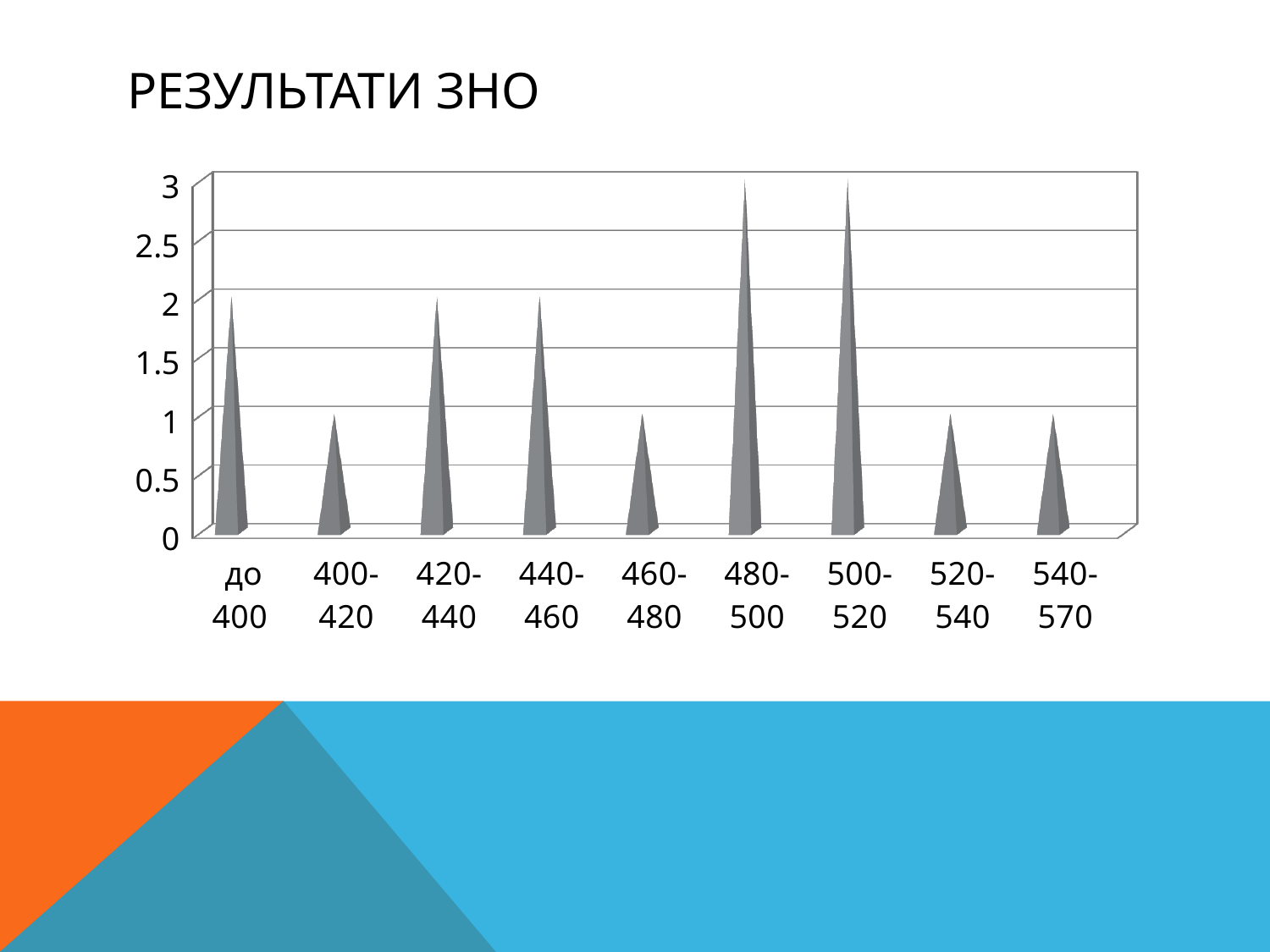
Which is larger, the value for до 400 or the value for 400-420? до 400 What is the value for the category до 400? 2 Is the value for 500-520 greater or less than 2.5? greater Which is larger, the value for 500-520 or the value for 520-540? 500-520 What kind of chart is shown on the slide? bar chart What is the title of the chart? РЕЗУЛЬТАТИ ЗНО How many categories are shown on the x axis of the chart? 9 What is the value for the category 540-570? 1 What is the difference between the value for 480-500 and the value for 400-420? 2 What is the value for the category 480-500? 3 Is the value for 420-440 greater or less than 1.5? greater What is the value for the category 460-480? 1